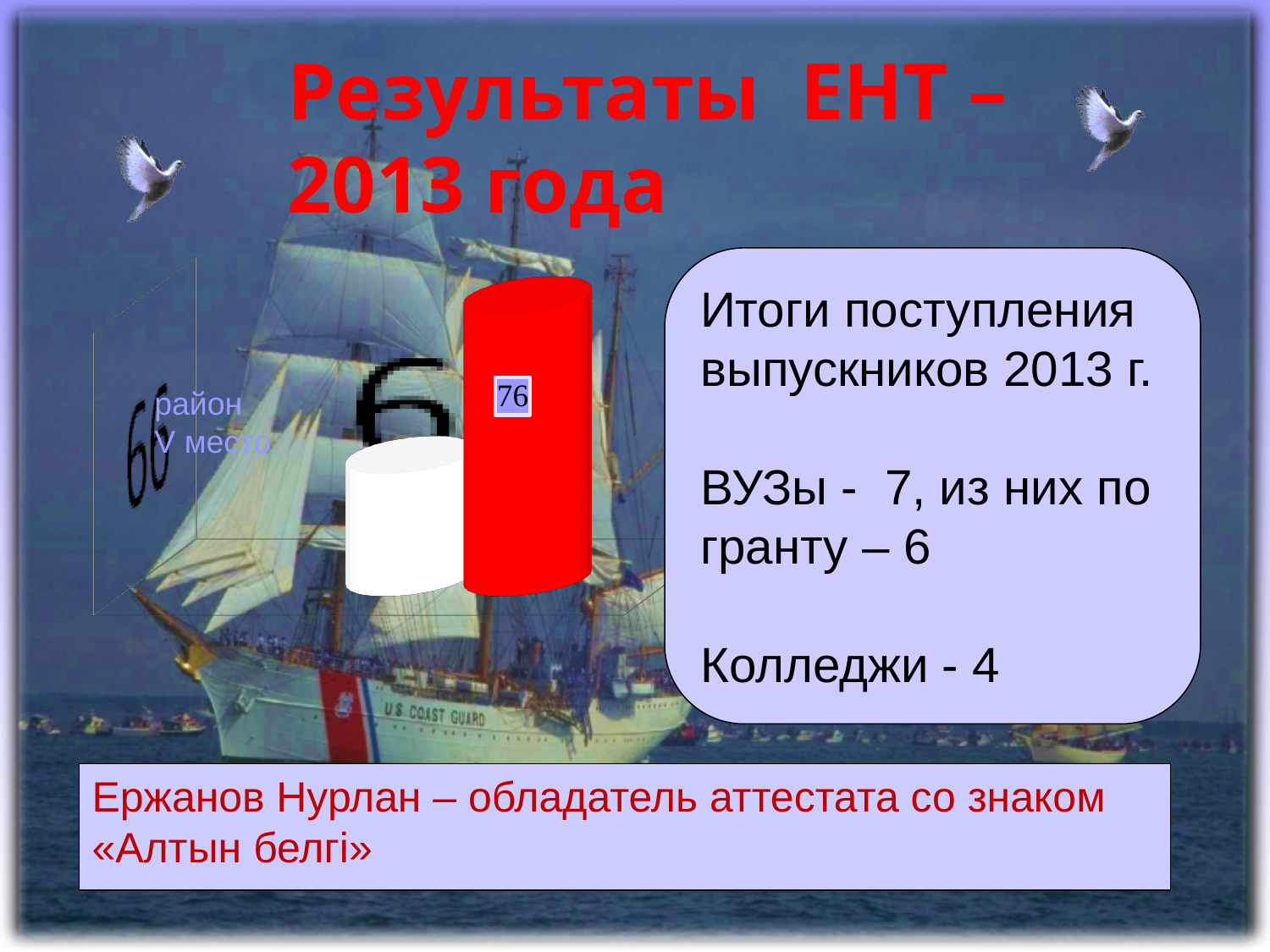
What colours are the two bars in the chart? white and red Which bar has the highest value in the chart? the red bar Which bar has the lowest value in the chart? the white bar Which bar is taller in the chart, the red bar or the white bar? the red bar What kind of chart is shown on the slide? bar chart What value is labelled on the red bar in the chart? 76 How many bars are plotted in the chart? 2 What is the title of the slide containing the chart? Результаты ЕНТ – 2013 года